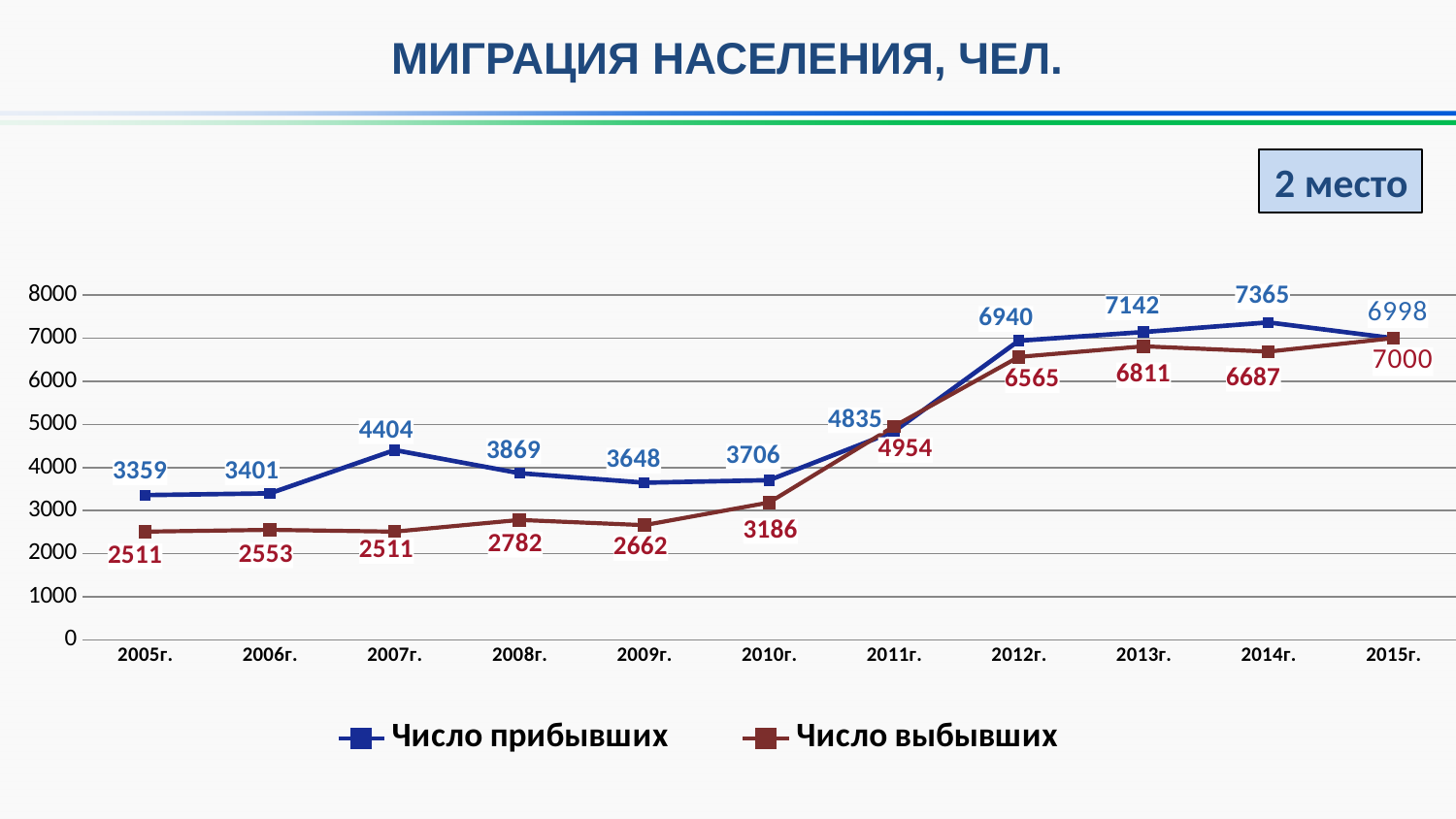
What is the difference between Число прибывших in 2014г. and in 2013г.? 223 What is the value of Число выбывших in 2010г.? 3186 What is the title of the chart? МИГРАЦИЯ НАСЕЛЕНИЯ, ЧЕЛ. How many years are shown on the x axis? 11 How many series does the legend list? 2 What is the value of Число выбывших in 2015г.? 7000 What kind of chart is shown on the slide? line chart In which year is Число прибывших highest? 2014г. Which is larger in 2011г.: Число прибывших or Число выбывших? Число выбывших What is the value of Число прибывших in 2007г.? 4404 What is the difference between Число прибывших and Число выбывших in 2012г.? 375 In which year is Число прибывших lowest? 2005г.